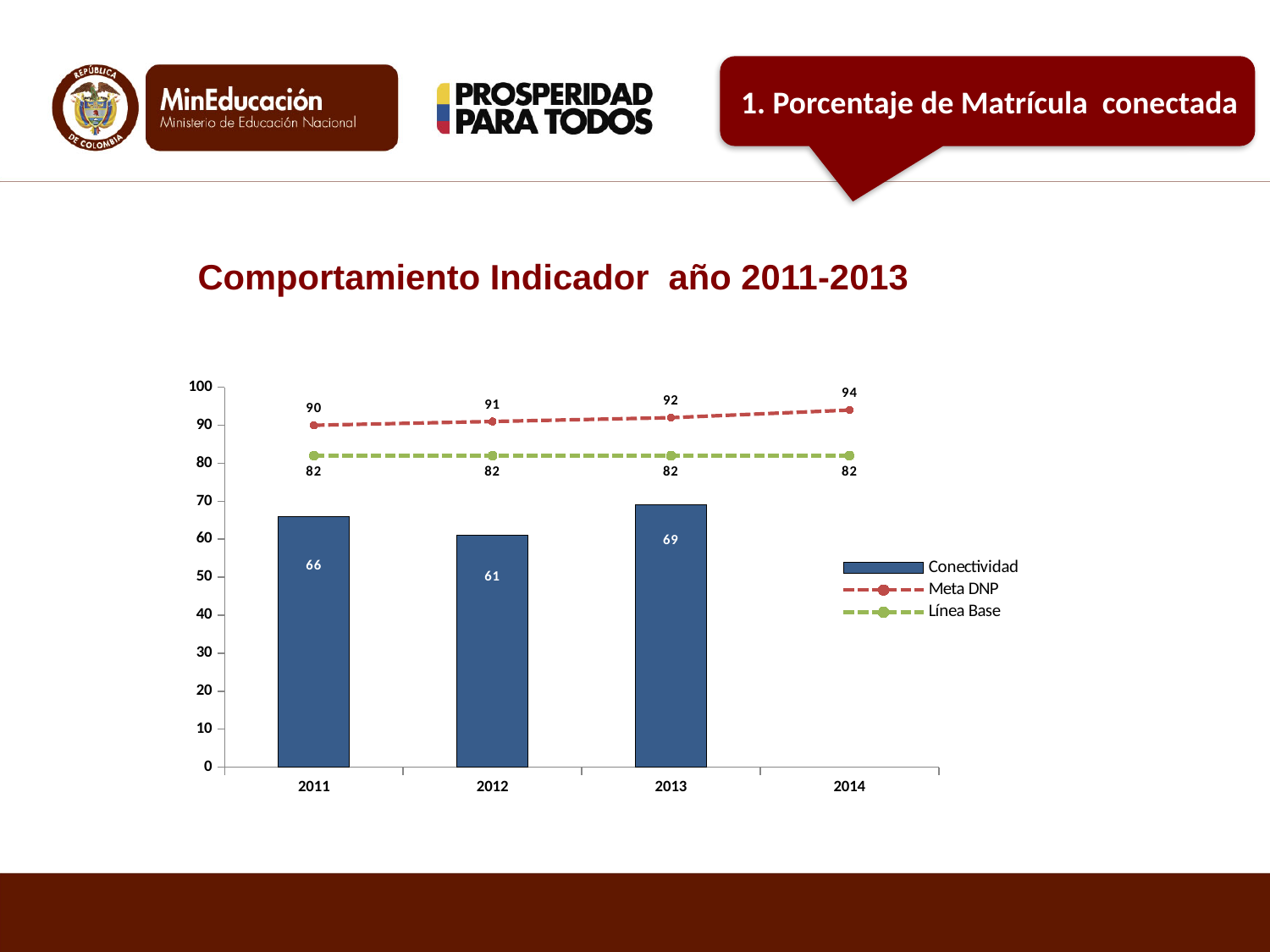
Which year has the highest Conectividad value? 2013 Does the Meta DNP series rise or fall from 2011 to 2014? rise How many years are shown on the x axis? 4 How many series does the legend list? 3 What is the title of the chart? Comportamiento Indicador año 2011-2013 What is the Conectividad value for 2012? 61 What is the difference between the Meta DNP and Conectividad values in 2013? 23 What is the Meta DNP value for 2014? 94 Which is larger, the Conectividad value for 2011 or for 2012? 2011 Is the Conectividad value for 2013 greater or less than 60? greater Which year has the lowest Conectividad value? 2012 What is the Línea Base value for 2011? 82